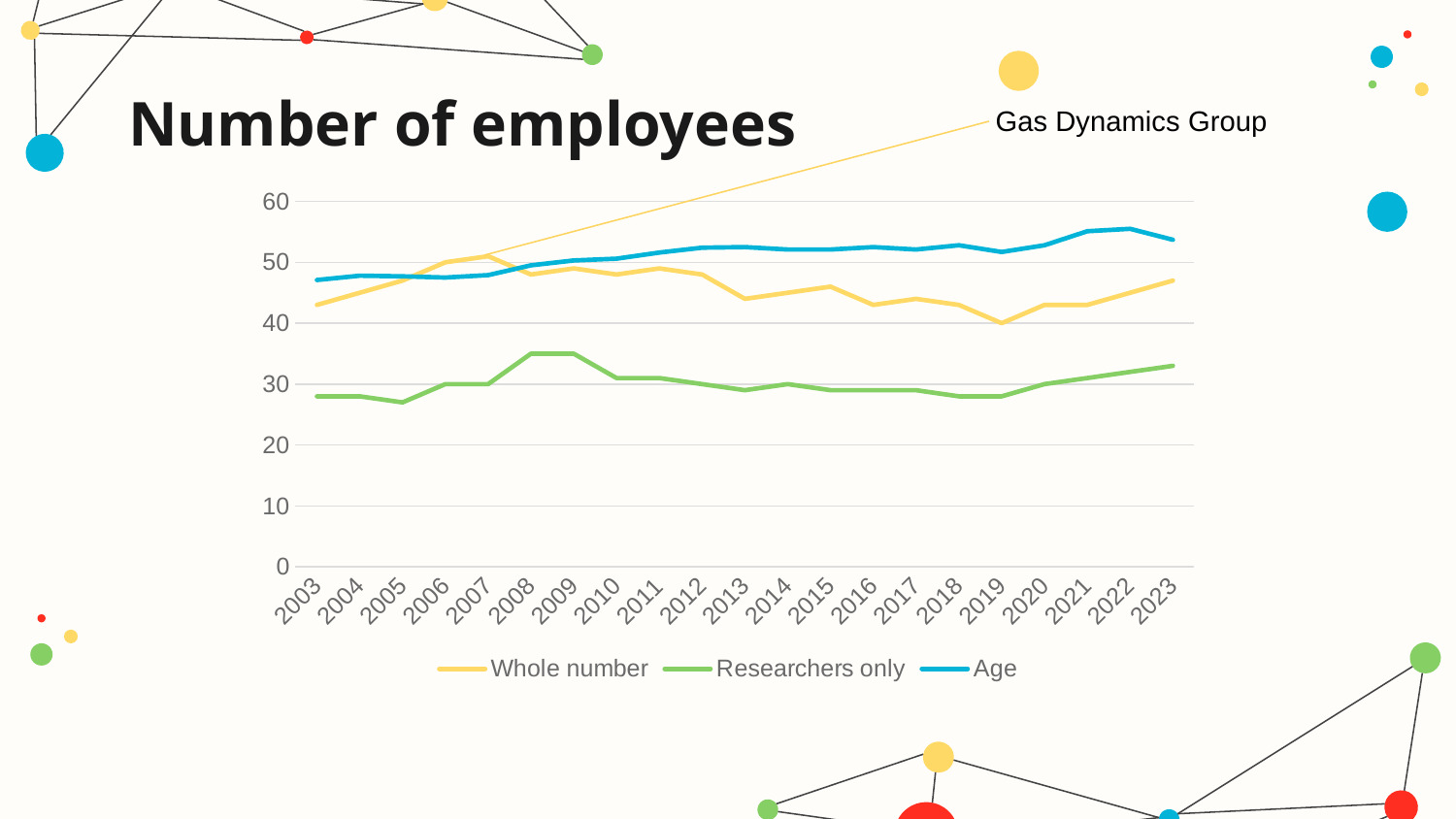
What kind of chart is shown on the slide? line chart What is the title of the chart? Number of employees In 2003, which is larger: Age or Whole number? Age Is the value for Researchers only in 2008 greater or less than 30? greater Is the value for Age in 2023 greater or less than 50? greater How many years are shown on the x axis? 21 Which series is drawn in green? Researchers only Is the value for Whole number in 2019 greater or less than 50? less How many series does the legend list? 3 Does the Researchers only series rise or fall from 2019 to 2023? rise In 2023, which is larger: Whole number or Researchers only? Whole number